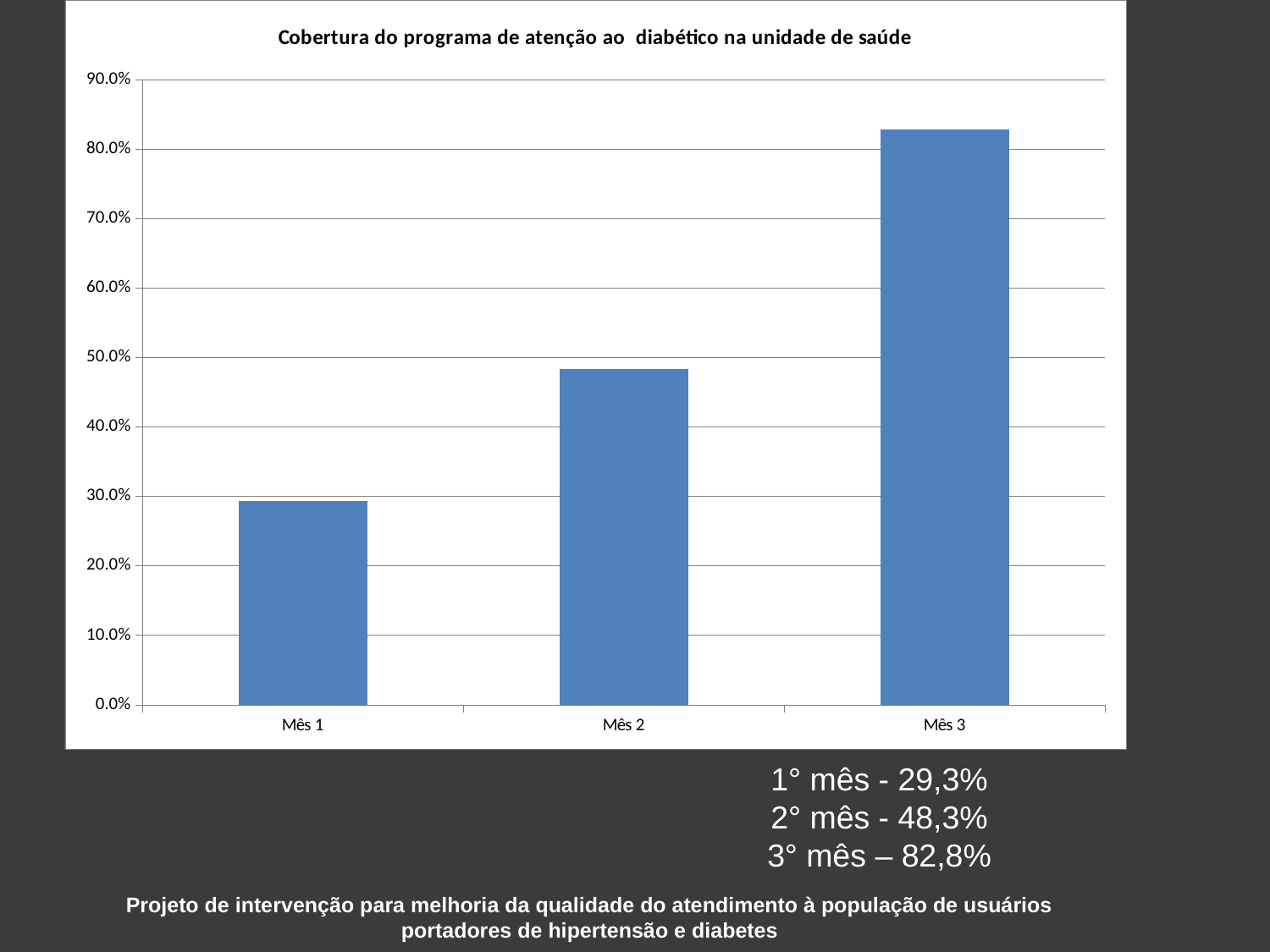
Which is larger, the value for Mês 1 or the value for Mês 2? Mês 2 What is the title of the chart? Cobertura do programa de atenção ao diabético na unidade de saúde Do the coverage values rise or fall from Mês 1 to Mês 3? rise According to the text on the slide, what is the coverage for the 1° mês? 29,3% Which month has the lowest coverage value? Mês 1 Which month has the highest coverage value? Mês 3 According to the text on the slide, what is the coverage for the 2° mês? 48,3% Is the value for Mês 3 greater or less than 80.0%? greater What type of chart is shown on the slide? bar chart How many categories (months) are plotted on the chart? 3 According to the text on the slide, what is the coverage for the 3° mês? 82,8% Is the value for Mês 2 greater or less than 50.0%? less